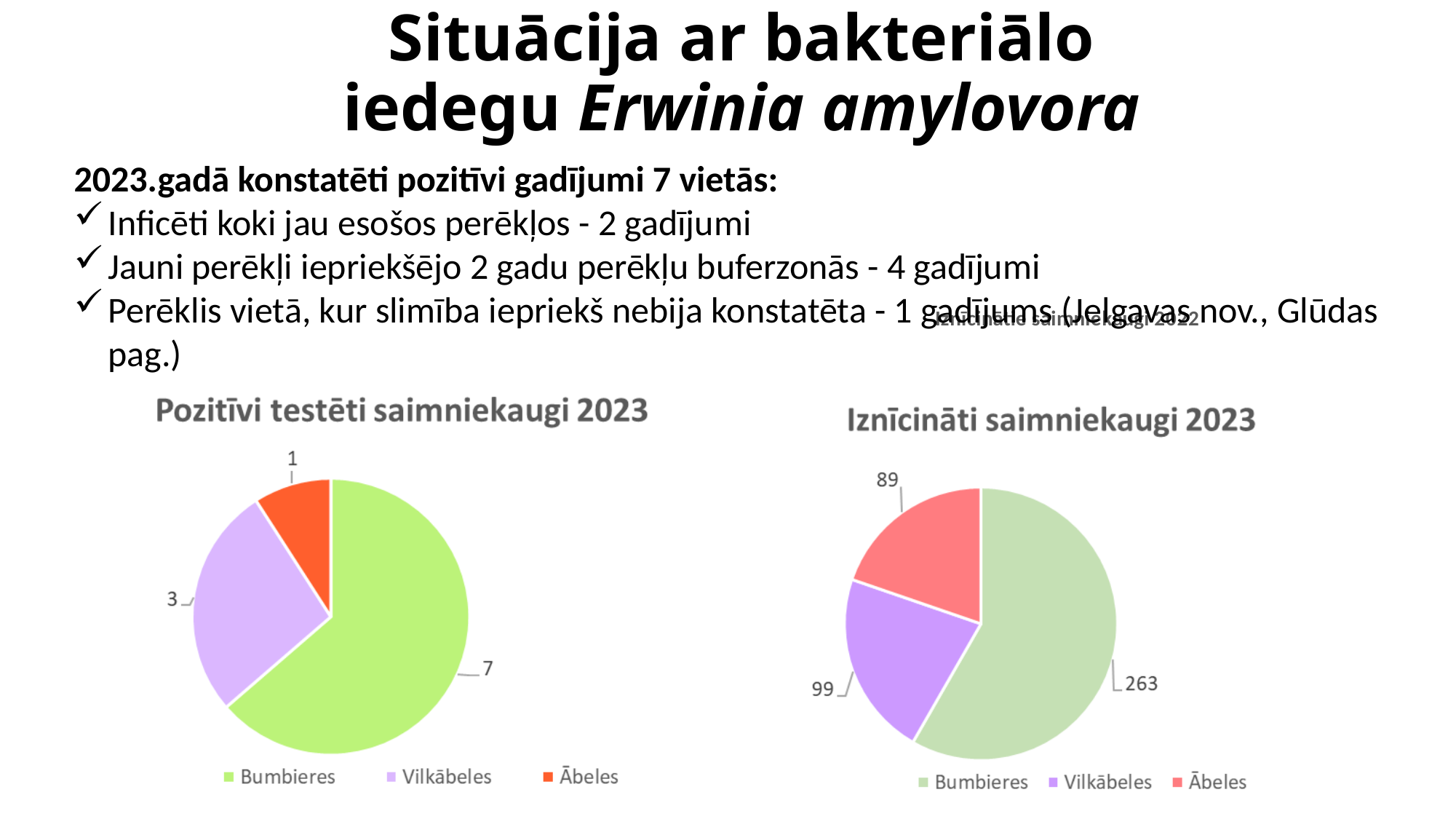
What are the legend entries of the chart titled 'Iznīcināti saimniekaugi 2023'? Bumbieres, Vilkābeles, Ābeles In the chart titled 'Pozitīvi testēti saimniekaugi 2023', what is the value for Bumbieres? 7 In the chart titled 'Iznīcināti saimniekaugi 2023', what is the difference between the values for Bumbieres and Vilkābeles? 164 In the chart titled 'Iznīcināti saimniekaugi 2023', what is the value for Bumbieres? 263 How many categories does the chart titled 'Pozitīvi testēti saimniekaugi 2023' show? 3 In the chart titled 'Pozitīvi testēti saimniekaugi 2023', which category has the smallest slice? Ābeles In the chart titled 'Pozitīvi testēti saimniekaugi 2023', what is the difference between the values for Bumbieres and Ābeles? 6 In the chart titled 'Iznīcināti saimniekaugi 2023', which category has the largest slice? Bumbieres In the chart titled 'Iznīcināti saimniekaugi 2023', what is the value for Ābeles? 89 In the chart titled 'Pozitīvi testēti saimniekaugi 2023', what is the value for Vilkābeles? 3 In the chart titled 'Iznīcināti saimniekaugi 2023', which is larger, the value for Vilkābeles or the value for Ābeles? Vilkābeles What kind of chart is the chart titled 'Iznīcināti saimniekaugi 2023'? Pie chart